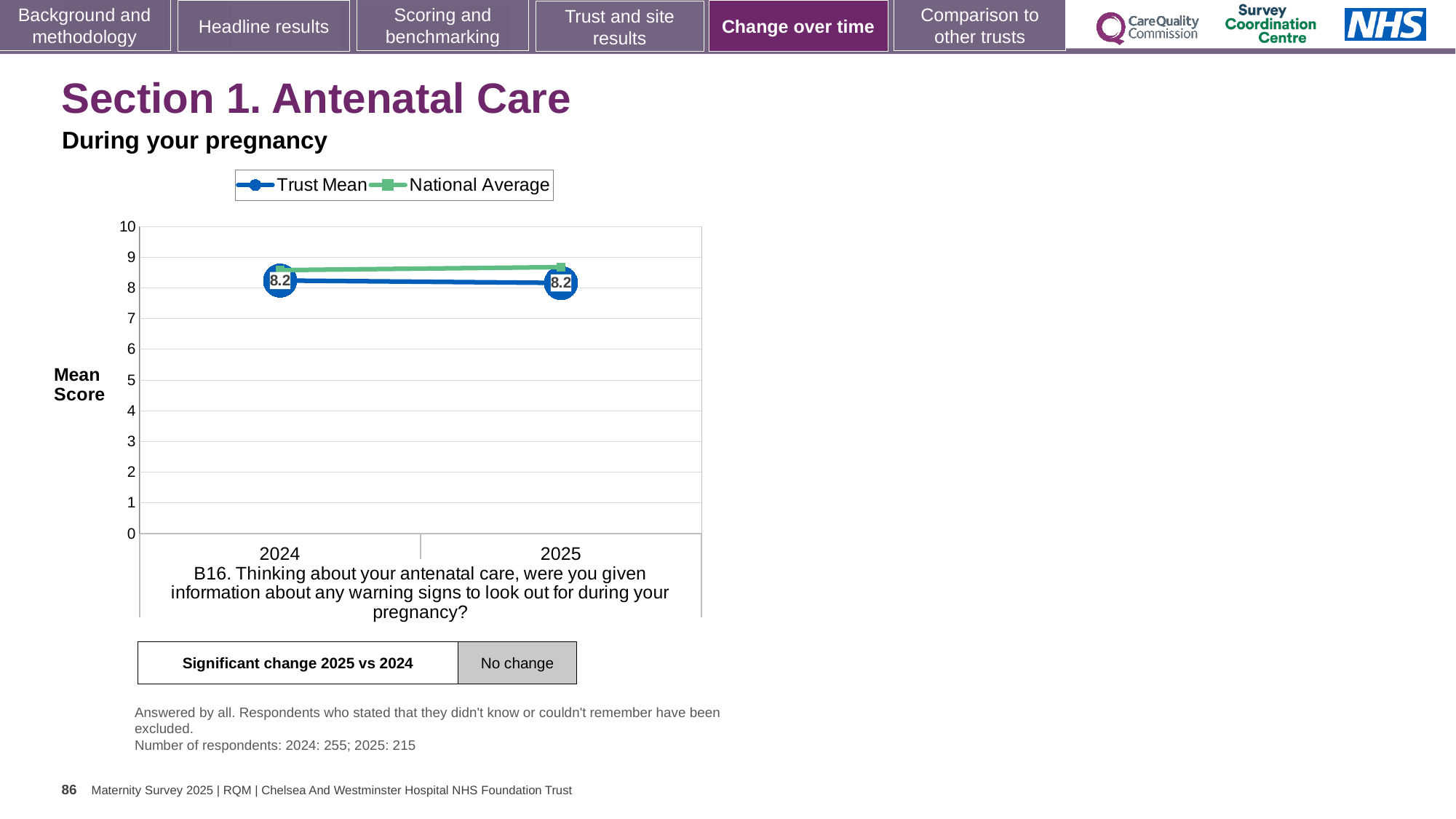
How many years are plotted on the x axis? 2 Is the National Average value for 2024 greater or less than 8? greater What is the label on the y axis of the chart? Mean Score Does the Trust Mean rise, fall or stay the same from 2024 to 2025? Stays the same How many series does the legend list? 2 What kind of chart is shown on the slide? Line chart Is the National Average value for 2025 greater or less than 9? less What is the Trust Mean score for 2025? 8.2 What are the two series named in the legend? Trust Mean and National Average In 2025, which is higher: the Trust Mean or the National Average? National Average What is the Trust Mean score for 2024? 8.2 What is the difference between the Trust Mean in 2025 and in 2024? 0